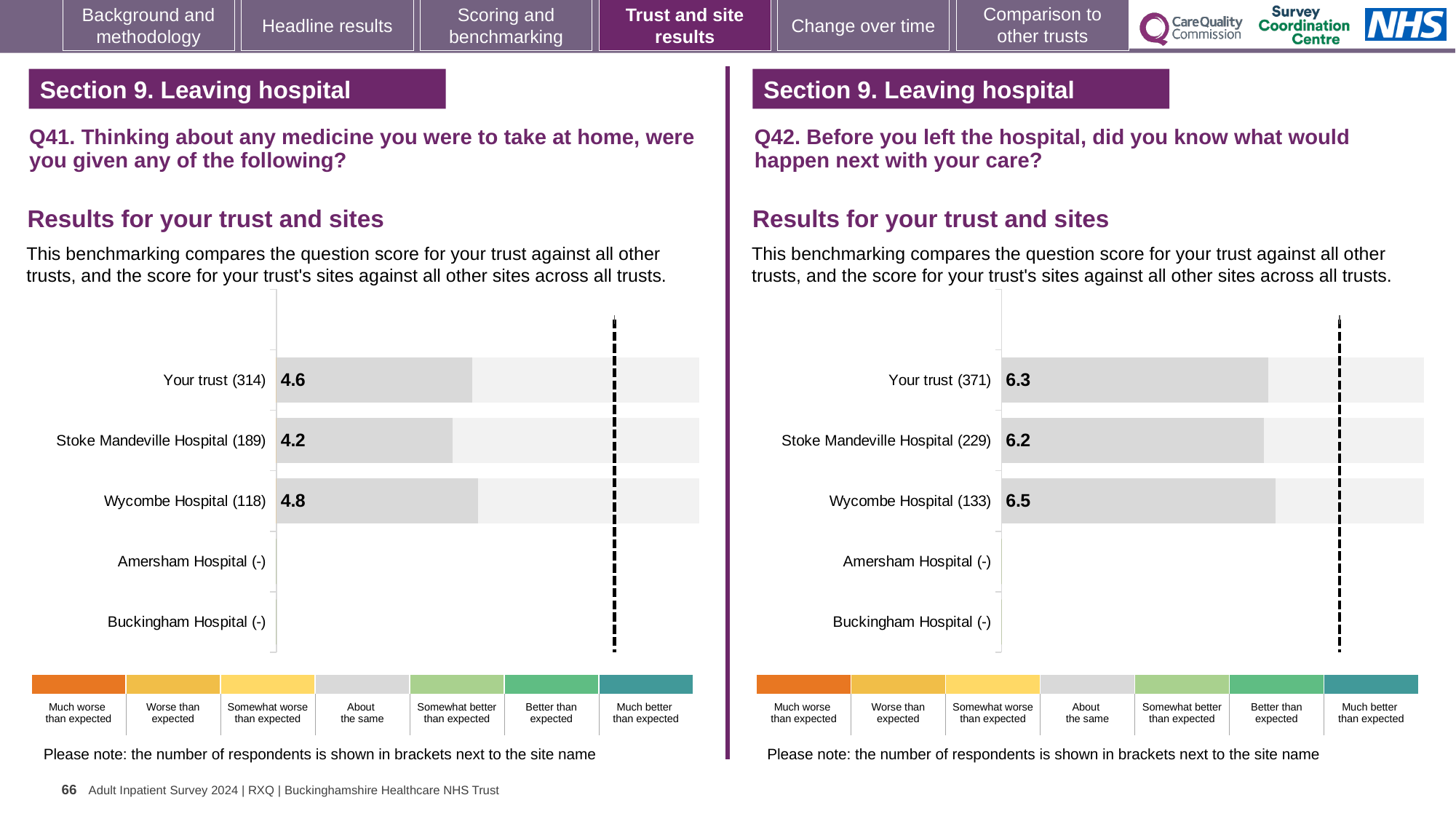
In the Q42 chart on the right, what is the difference between the scores for Wycombe Hospital and Your trust? 0.2 In the Q41 chart on the left, what is the difference between the scores for Wycombe Hospital and Stoke Mandeville Hospital? 0.6 In the Q41 chart on the left, what is the score for Your trust? 4.6 What kind of chart is used in the Q42 chart on the right? Bar chart In the Q42 chart on the right, which site has the lowest score among those with a value shown? Stoke Mandeville Hospital In the Q42 chart on the right, what is the score for Wycombe Hospital? 6.5 In the Q41 chart on the left, what is the score for Stoke Mandeville Hospital? 4.2 In the Q41 chart on the left, which site has the highest score? Wycombe Hospital In the Q42 chart on the right, which is larger: the score for Wycombe Hospital or the score for Your trust? Wycombe Hospital How many site rows are listed in the Q41 chart on the left? 5 In the Q42 chart on the right, what is the score for Your trust? 6.3 In the Q41 chart on the left, how many respondents are shown in brackets for Your trust? 314